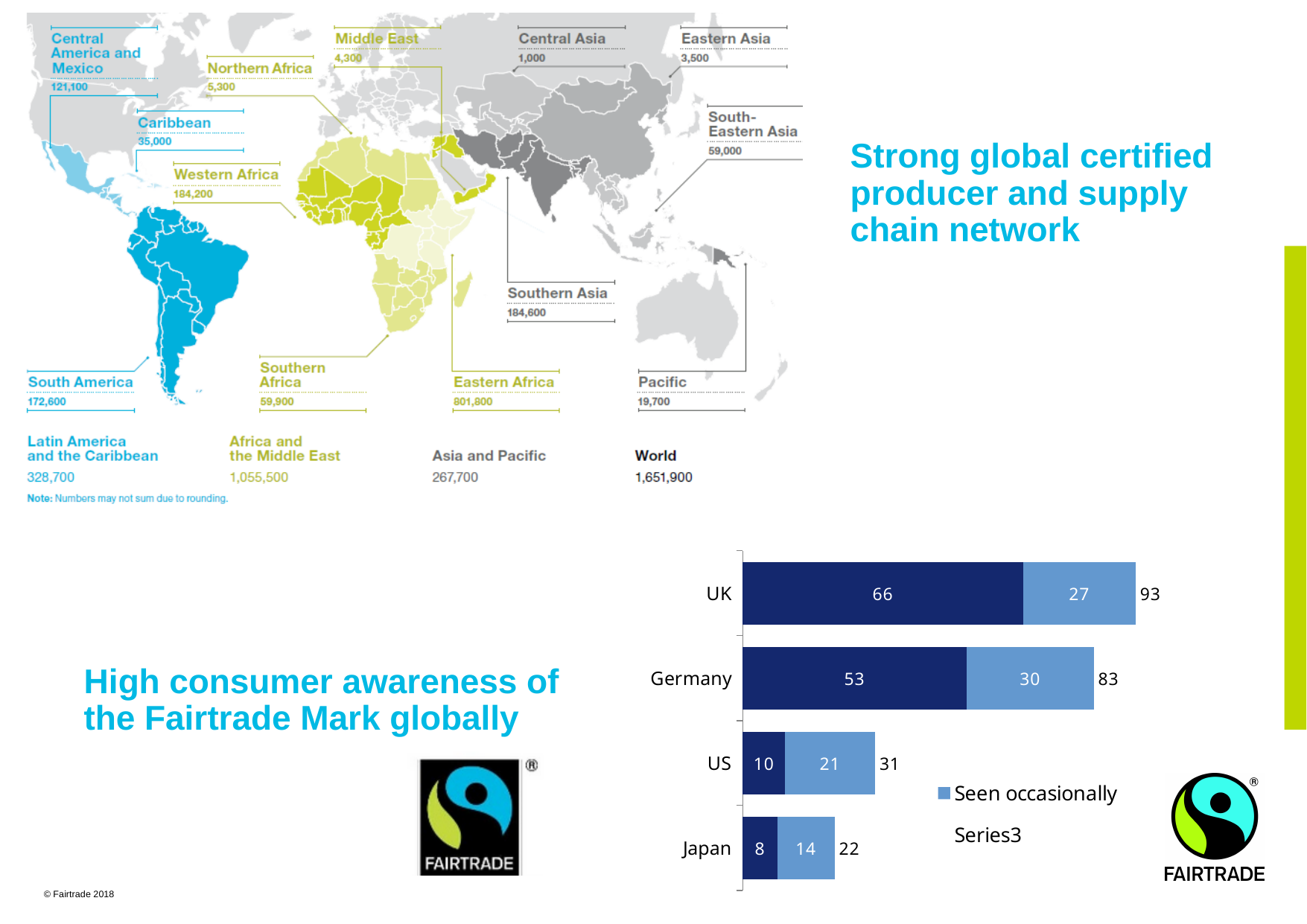
In the bar chart, which has the larger 'Seen occasionally' value, Germany or the UK? Germany In the bar chart, what is the total value shown at the end of the UK bar? 93 In the bar chart, what is the difference between the UK total (93) and the Germany total (83)? 10 What kind of chart is shown at the bottom right of the slide? bar chart In the bar chart, what is the 'Seen occasionally' value for Germany? 30 In the bar chart, how many countries are listed on the vertical axis? 4 In the bar chart, what is the difference between the dark blue segment for Germany (53) and the dark blue segment for the US (10)? 43 In the bar chart, what is the 'Seen occasionally' value for Japan? 14 In the bar chart, what is the value of the dark blue segment for the US? 10 In the bar chart, which country has the highest total? UK In the bar chart, which country has the lowest total? Japan In the bar chart, what two entries does the legend list? Seen occasionally and Series3